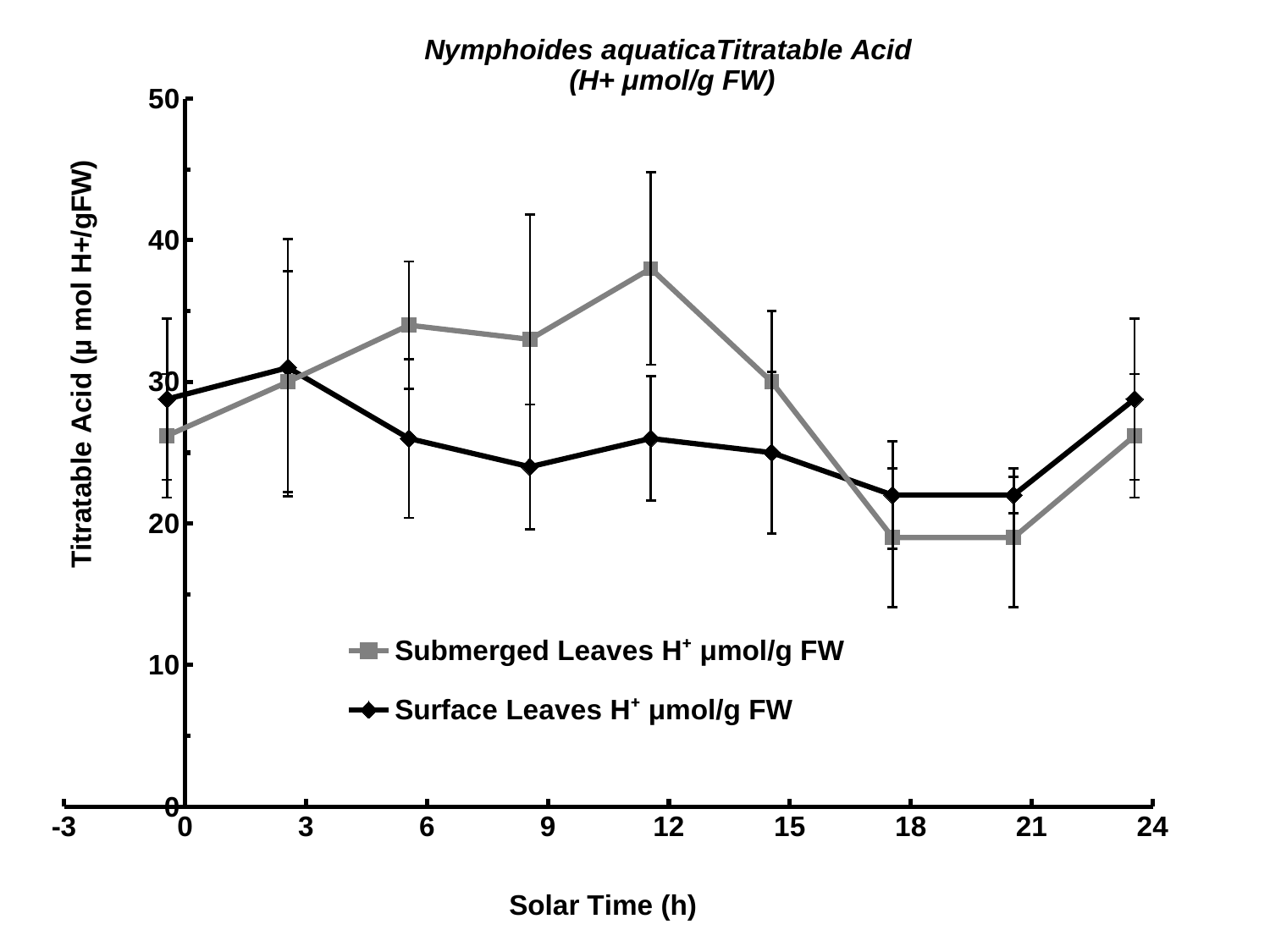
At about 18 h, which series has the larger value, Submerged Leaves or Surface Leaves? Surface Leaves How many data points are plotted for the Submerged Leaves series? 9 Does the Surface Leaves series rise or fall between about 21 h and 24 h? Rise Is the Surface Leaves value at about 9 h greater or less than 30? less Is the Submerged Leaves value at about 12 h greater or less than 30? greater Does the Submerged Leaves series rise or fall between about 12 h and 18 h? Fall What is the title of the x axis? Solar Time (h) What kind of chart is shown on the slide? Line chart Is the Submerged Leaves value at about 6 h greater or less than 30? greater At about 12 h, which series has the larger value, Submerged Leaves or Surface Leaves? Submerged Leaves How many series does the legend list? 2